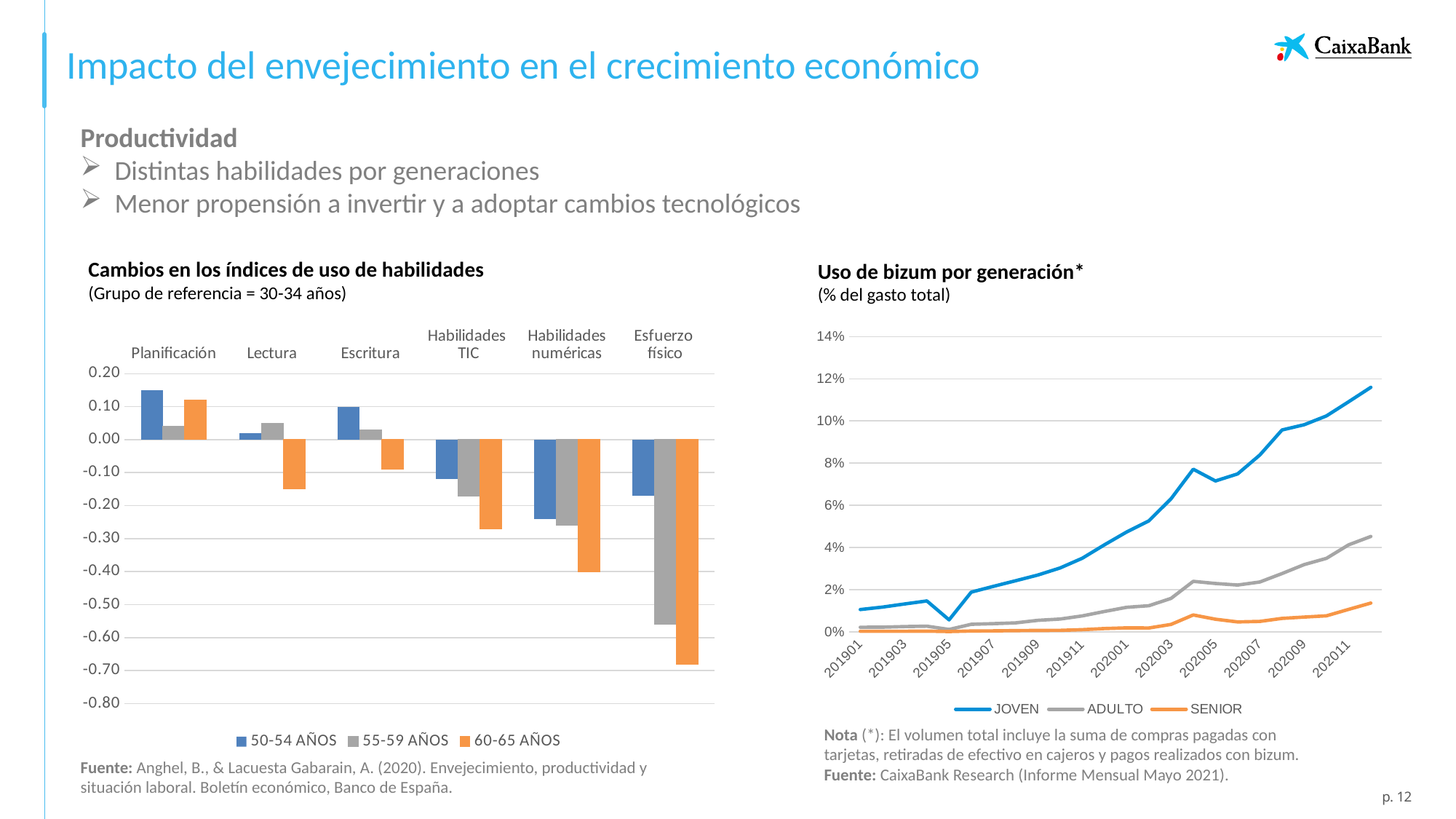
How many categories are shown on the x axis of 'Cambios en los índices de uso de habilidades'? 6 In 'Uso de bizum por generación*', is the JOVEN value at 202011 greater or less than 10%? greater In 'Uso de bizum por generación*', which series has the highest value at 202011? JOVEN What kind of chart is 'Cambios en los índices de uso de habilidades'? bar chart How many series does the legend of 'Cambios en los índices de uso de habilidades' list? 3 How many series does the legend of 'Uso de bizum por generación*' list? 3 In 'Uso de bizum por generación*', does the JOVEN series rise or fall overall from 201901 to 202011? rise In 'Cambios en los índices de uso de habilidades', which is larger for Lectura: the 55-59 AÑOS value or the 60-65 AÑOS value? 55-59 AÑOS In 'Cambios en los índices de uso de habilidades', is the 50-54 AÑOS value for Planificación greater or less than 0.10? greater What kind of chart is 'Uso de bizum por generación*'? line chart In 'Cambios en los índices de uso de habilidades', which category has the lowest value for the 60-65 AÑOS series? Esfuerzo físico In 'Cambios en los índices de uso de habilidades', is the 60-65 AÑOS value for Esfuerzo físico greater or less than -0.60? less